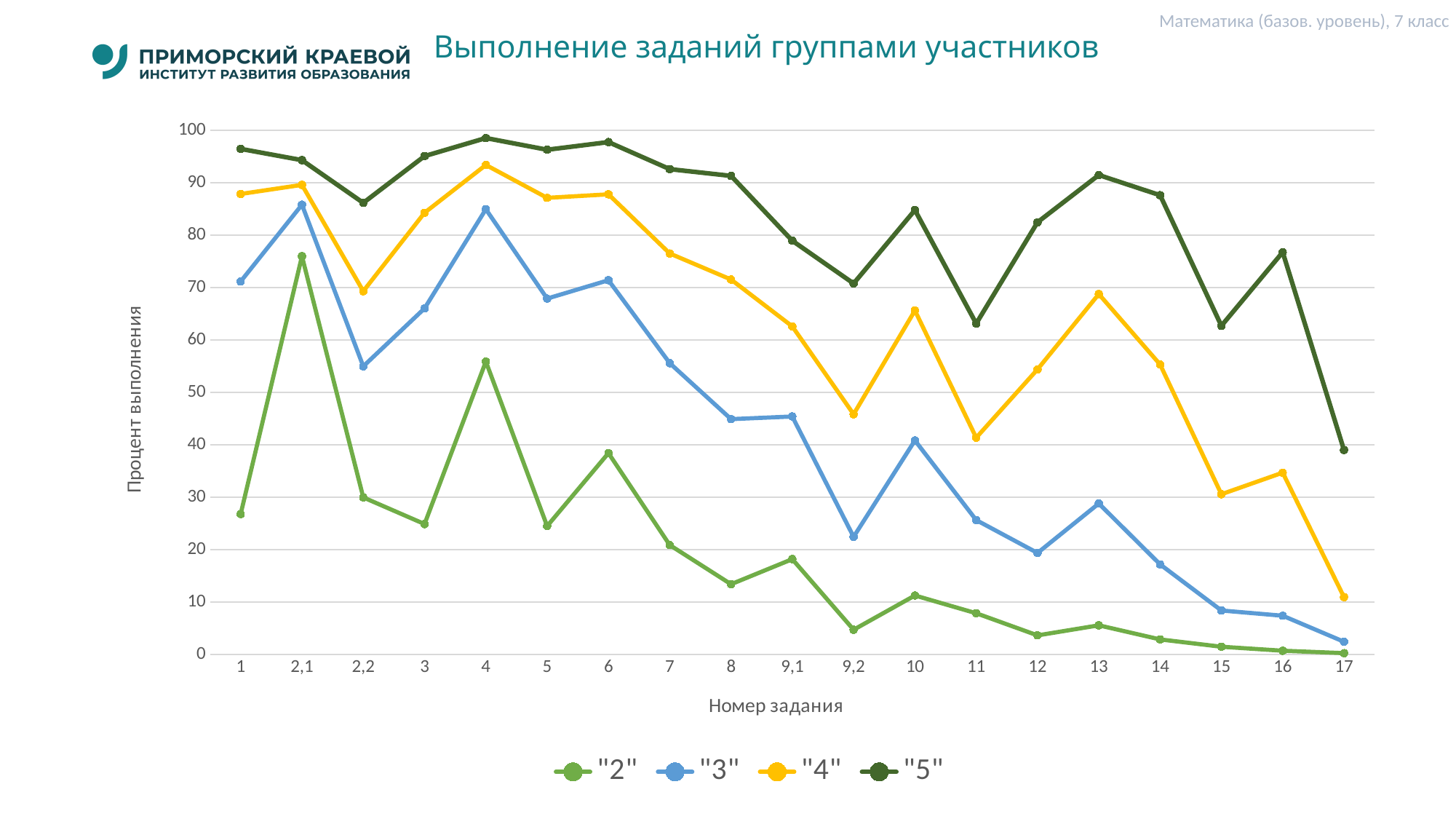
Which series has the lowest value for task 1? "2" Overall, do the values of the "3" series rise or fall from task 6 to task 17? fall What is the label of the y axis? Процент выполнения How many series does the legend list? 4 For the "3" series, which is larger: the value for task 4 or the value for task 5? task 4 For the "2" series, is the value for task 2,1 greater or less than 70? greater What kind of chart is shown on the slide? line chart What is the title of the chart? Выполнение заданий группами участников For the "5" series, is the value for task 17 greater or less than 50? less How many task numbers are shown along the x axis? 19 For the "4" series, is the value for task 4 greater or less than 90? greater Which series has the highest value for task 17? "5"